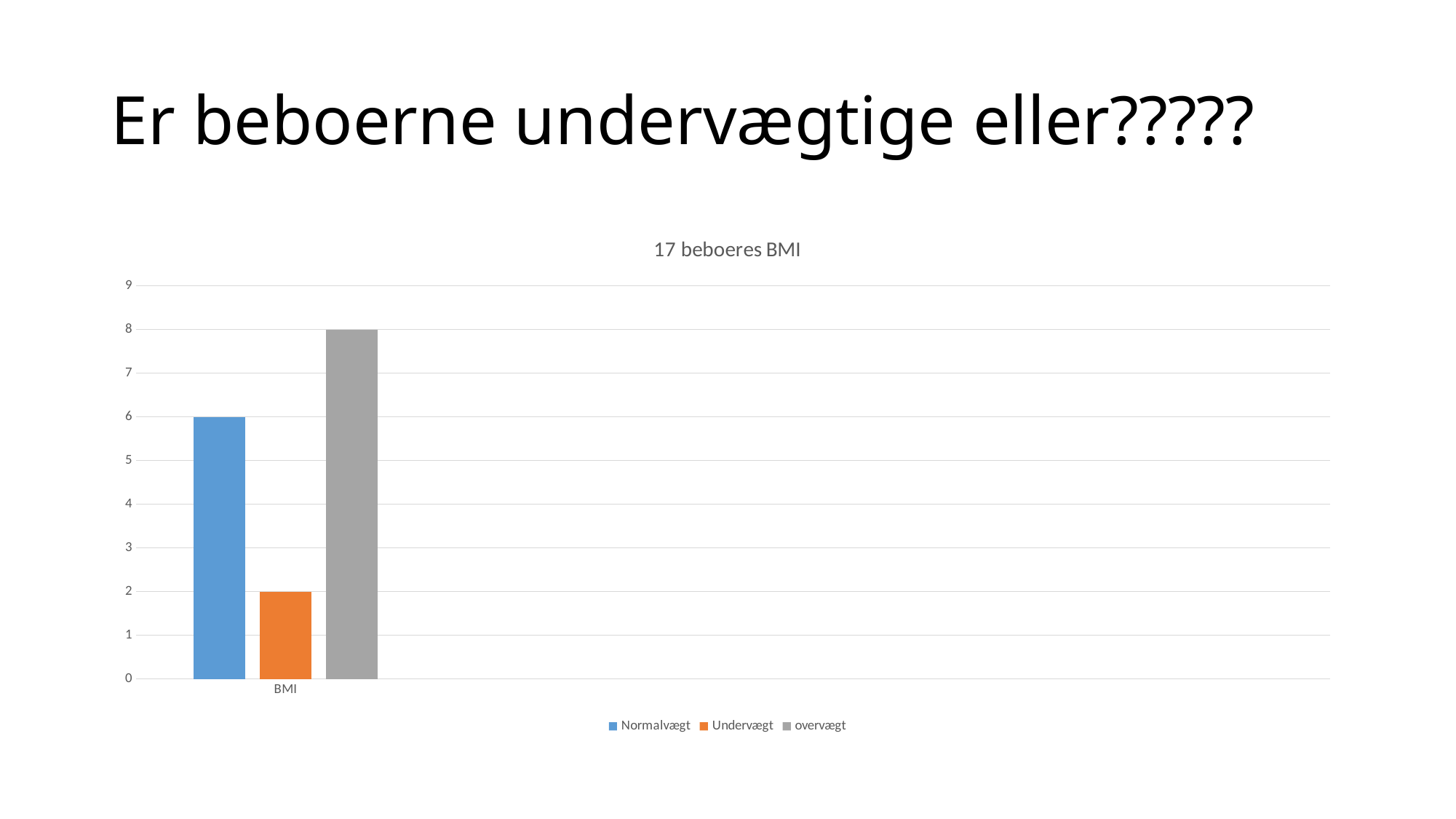
What is the value for overvægt? 8 Which series has the lowest value? Undervægt Is the value for overvægt greater or less than 7? greater Which is larger, the value for Normalvægt or the value for Undervægt? Normalvægt What is the value for Undervægt? 2 How many categories are shown on the x axis? 1 What is the title of the chart? 17 beboeres BMI What is the difference between the values for overvægt and Normalvægt? 2 What is the value for Normalvægt? 6 Which series has the highest value? overvægt What type of chart is shown on the slide? bar chart How many series does the legend list? 3